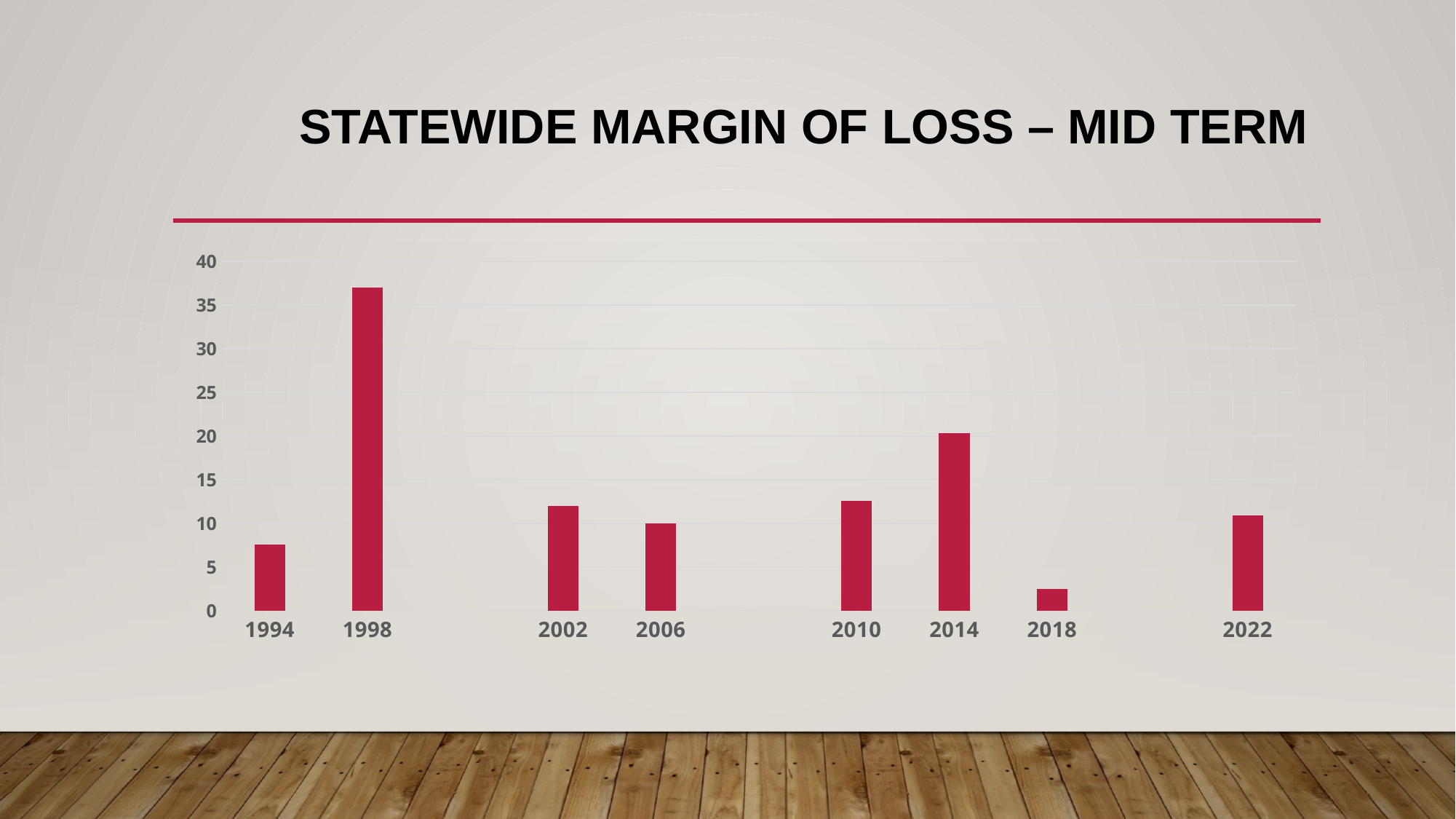
What is the title of the chart? Statewide Margin of Loss – Mid Term What kind of chart is shown on the slide? bar chart Which year has the highest margin of loss? 1998 Which year has the lowest margin of loss? 2018 Is the value for 2014 greater or less than 15? greater Is the value for 2018 greater or less than 5? less Is the value for 2010 greater or less than 10? greater Which year has the larger margin of loss, 1998 or 2014? 1998 How many years have bars plotted in the chart? 8 Which year has the larger margin of loss, 2014 or 2002? 2014